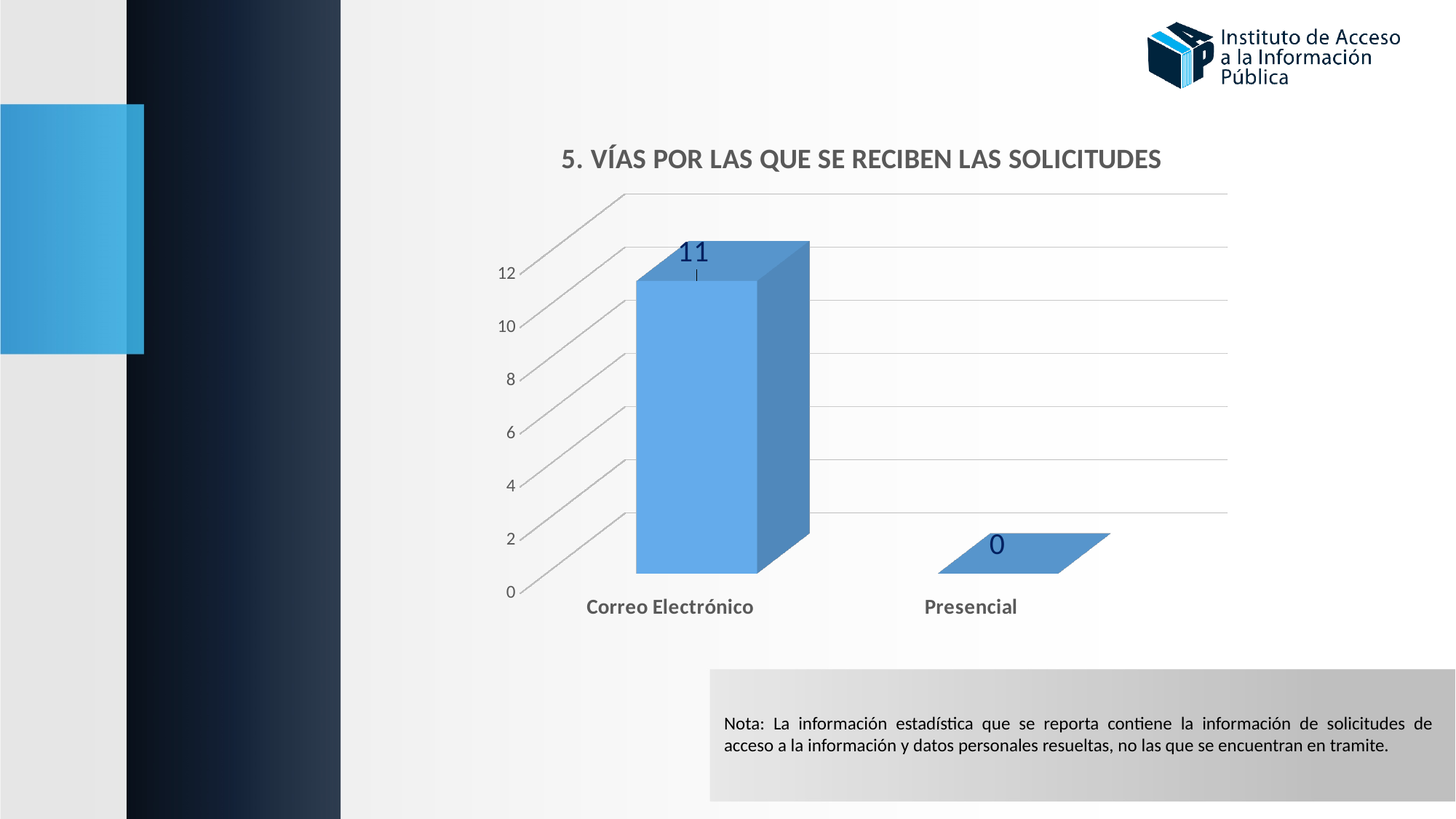
Is the value for Correo Electrónico greater or less than 10? greater Which category has the lowest value? Presencial What is the difference between the values for Correo Electrónico and Presencial? 11 What is the value for Correo Electrónico? 11 What is the value for Presencial? 0 What is the maximum value shown on the vertical axis? 12 Do the values rise or fall from Correo Electrónico to Presencial? fall Which category has the highest value? Correo Electrónico Which is larger, the value for Correo Electrónico or the value for Presencial? Correo Electrónico What is the title of the chart? 5. VÍAS POR LAS QUE SE RECIBEN LAS SOLICITUDES How many categories are shown on the x axis? 2 What kind of chart is shown on the slide? bar chart